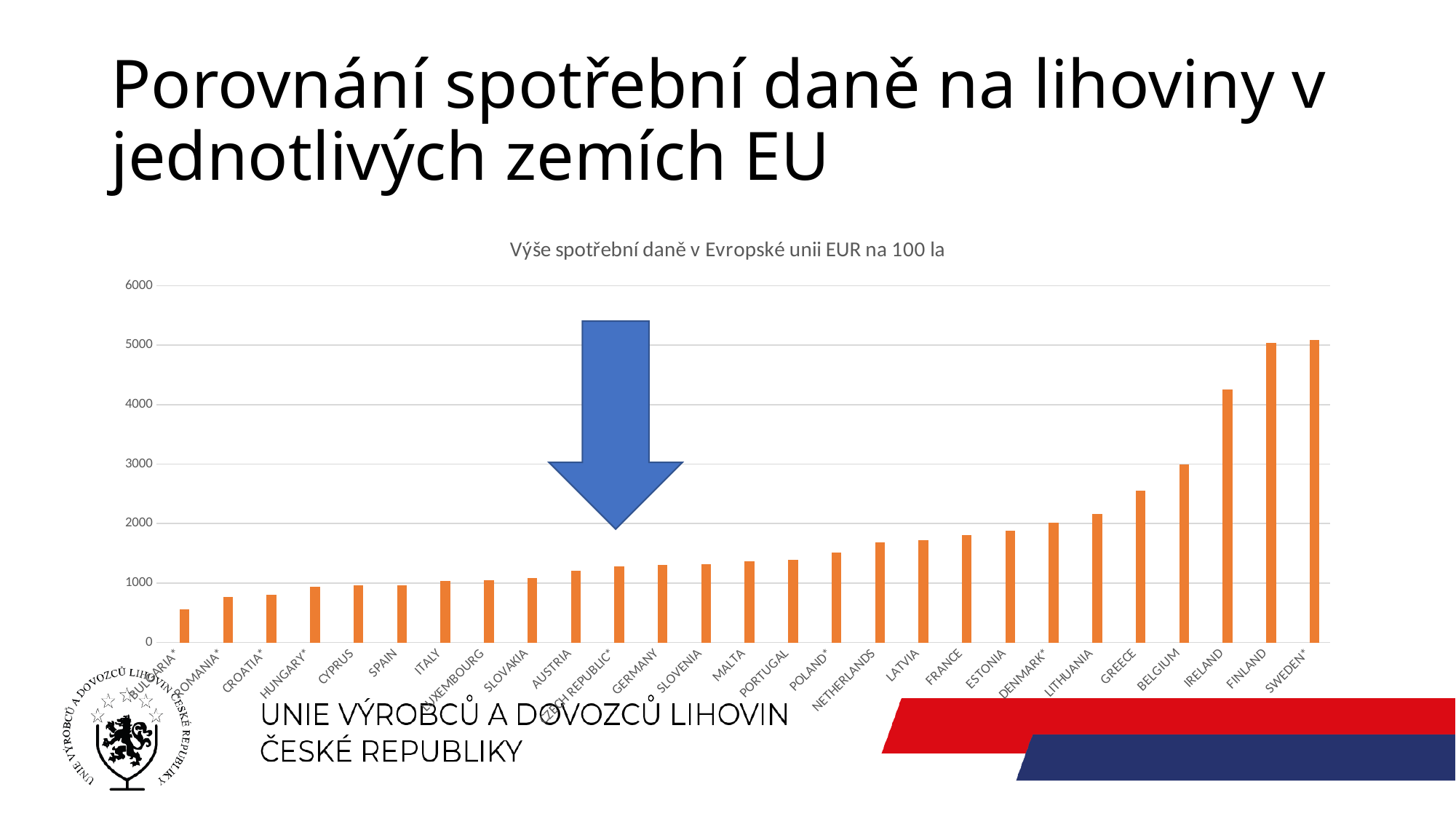
Which has the larger value, Ireland or Belgium? Ireland Is the value for Ireland greater or less than 4000? greater What kind of chart is shown on the slide? bar chart Is the value for Greece greater or less than 3000? less Do the values rise or fall from left to right along the x axis? rise How many countries are shown on the x axis of the chart? 27 Which country has the lowest value in the chart? Bulgaria* Is the value for Netherlands greater or less than 2000? less Which country's bar does the blue arrow point to? Czech Republic* What is the title of the chart? Výše spotřební daně v Evropské unii EUR na 100 la